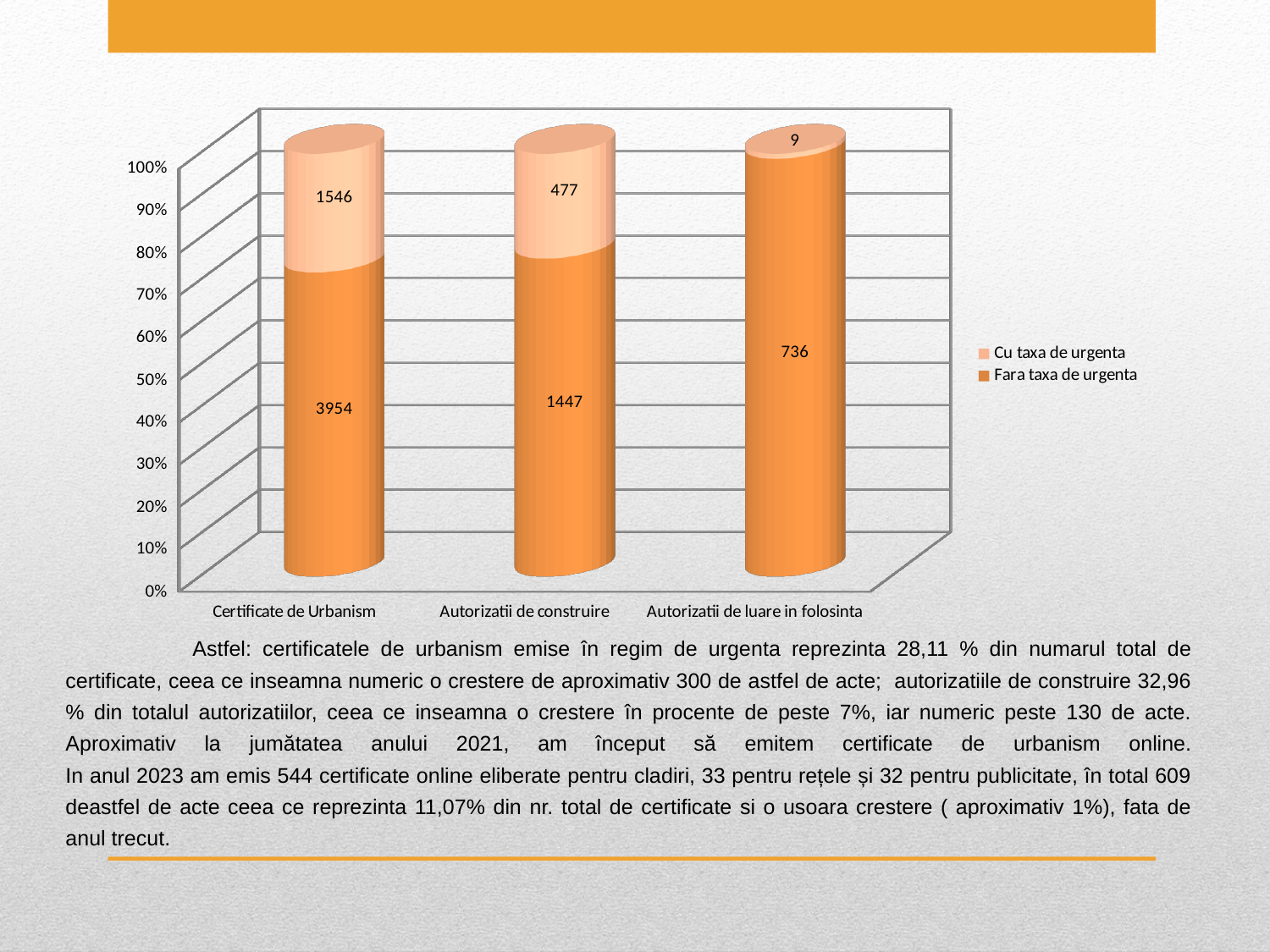
What kind of chart is shown on the slide? Stacked bar chart Which category has the lowest value for "Cu taxa de urgenta"? Autorizatii de luare in folosinta What is the value for "Cu taxa de urgenta" in the Autorizatii de construire category? 477 What is the value for "Fara taxa de urgenta" in the Certificate de Urbanism category? 3954 How many series does the legend list? 2 What is the total of the two values in the Autorizatii de construire bar? 1924 How many categories are shown on the x axis? 3 Which is larger: the "Cu taxa de urgenta" value for Certificate de Urbanism or for Autorizatii de construire? Certificate de Urbanism What is the value for "Fara taxa de urgenta" in the Autorizatii de luare in folosinta category? 736 Which category has the highest value for "Fara taxa de urgenta"? Certificate de Urbanism What is the difference between the "Fara taxa de urgenta" values for Certificate de Urbanism and Autorizatii de construire? 2507 What is the value for "Cu taxa de urgenta" in the Autorizatii de luare in folosinta category? 9